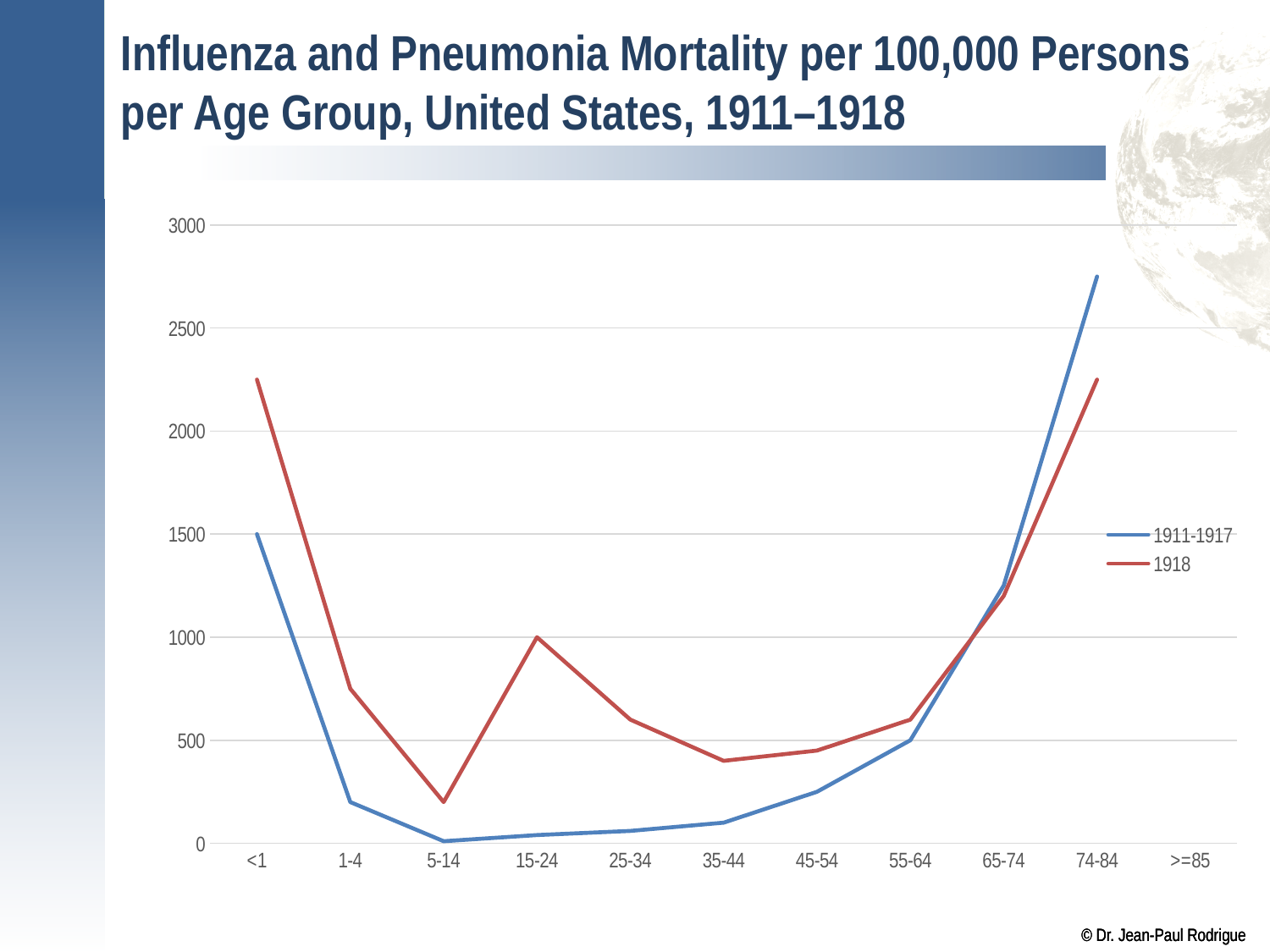
Which age group has the lowest value for the 1911-1917 series? 5-14 How many series does the legend list? 2 At age group 15-24, which series has the larger value, 1911-1917 or 1918? 1918 How many age groups are labelled on the x axis? 11 Is the value for the 1918 series at age group <1 greater or less than 2000? greater Which age group has the highest value for the 1911-1917 series? 74-84 Is the value for the 1918 series at age group 1-4 greater or less than 500? greater What kind of chart is shown on the slide? line chart What colour is the line for the 1918 series? red Which age group has the lowest value for the 1918 series? 5-14 Is the value for the 1911-1917 series at age group 74-84 greater or less than 2500? greater At age group 74-84, which series has the larger value, 1911-1917 or 1918? 1911-1917